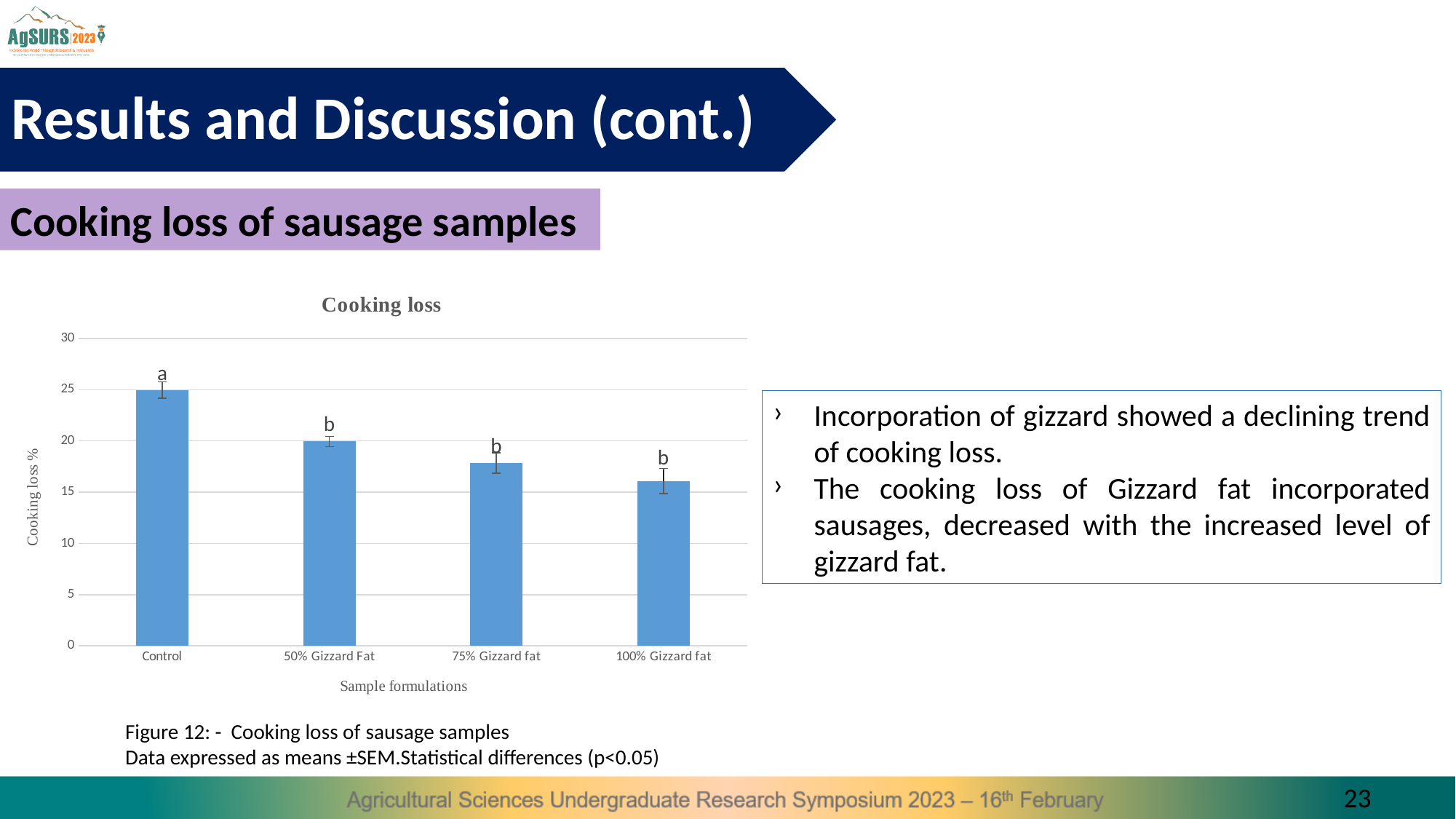
Is the cooking loss value for 100% Gizzard fat greater or less than 20? less What is the title of the chart? Cooking loss How many sample formulations are plotted in the Cooking loss chart? 4 Do the cooking loss values rise or fall from Control to 100% Gizzard fat along the x axis? fall Which has a higher cooking loss, 50% Gizzard Fat or 100% Gizzard fat? 50% Gizzard Fat What is the label on the y axis of the chart? Cooking loss % Which sample formulation has the lowest cooking loss? 100% Gizzard fat Is the cooking loss value for Control greater or less than 20? greater Which sample formulation has the highest cooking loss? Control Is the cooking loss value for 50% Gizzard Fat greater or less than 25? less What kind of chart is shown on the slide? bar chart